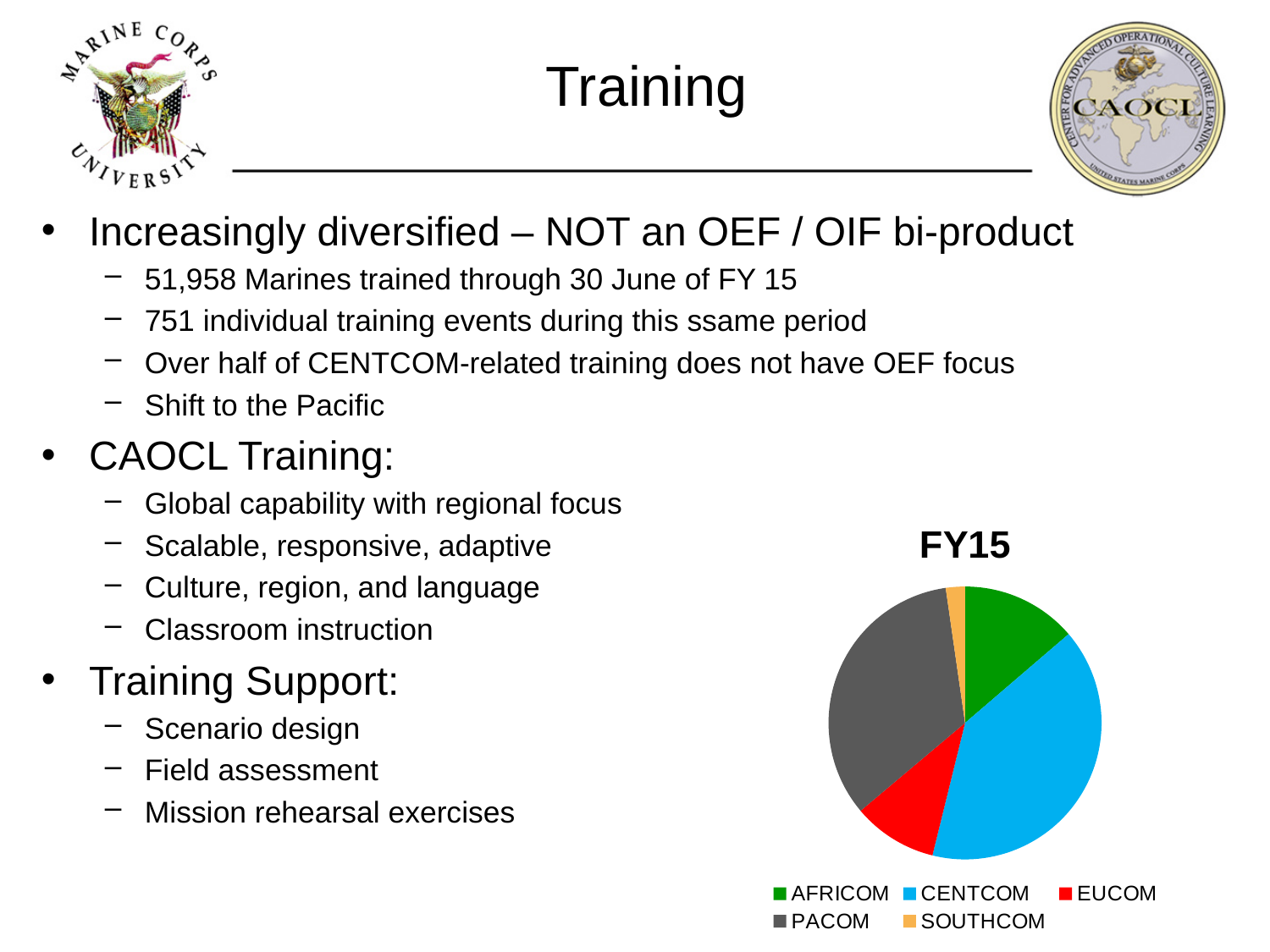
Which category is shown in green in the FY15 pie chart? AFRICOM How many categories does the FY15 pie chart show? 5 In the FY15 pie chart, which slice is larger, AFRICOM or SOUTHCOM? AFRICOM What is the title of the pie chart? FY15 Which category has the smallest slice in the FY15 pie chart? SOUTHCOM In the FY15 pie chart, which slice is larger, CENTCOM or PACOM? CENTCOM In the FY15 pie chart, which slice is larger, CENTCOM or AFRICOM? CENTCOM What kind of chart is shown on the slide? pie chart Which category has the largest slice in the FY15 pie chart? CENTCOM Which category has the second-largest slice in the FY15 pie chart? PACOM